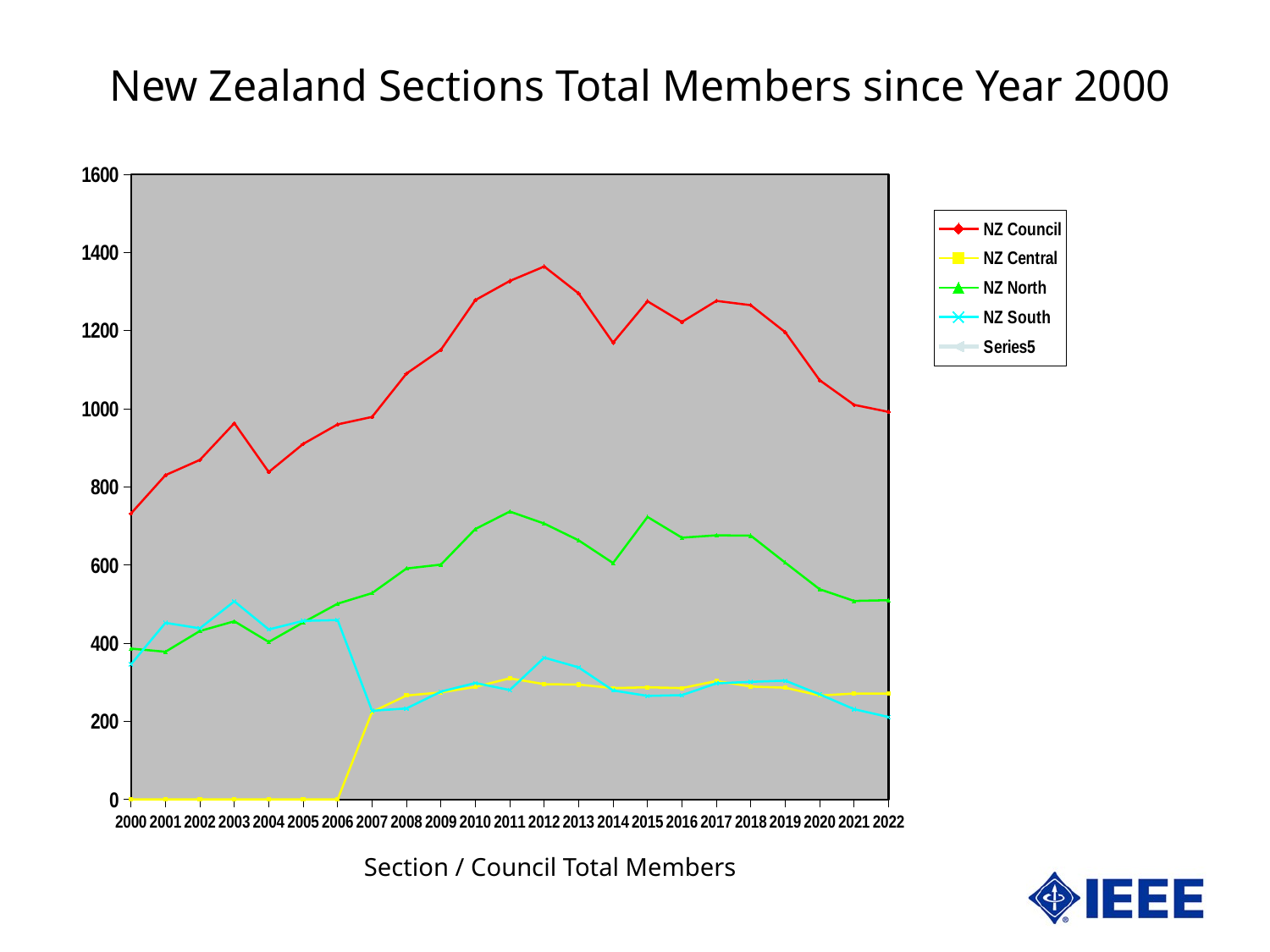
In which year is the NZ Council value lowest? 2000 What kind of chart is shown on the slide? line chart Which series has the larger value in 2022, NZ North or NZ South? NZ North Is the value for NZ South in 2007 greater or less than 400? less In which year does the NZ Council line reach its highest value? 2012 What is the title of the chart? New Zealand Sections Total Members since Year 2000 How many years are plotted along the x axis? 23 How many series does the legend list? 5 What is the value for NZ Central in 2000? 0 Does the NZ Council line rise or fall from 2012 to 2022? fall Is the value for NZ North in 2022 greater or less than 600? less Is the value for NZ Council in 2012 greater or less than 1200? greater